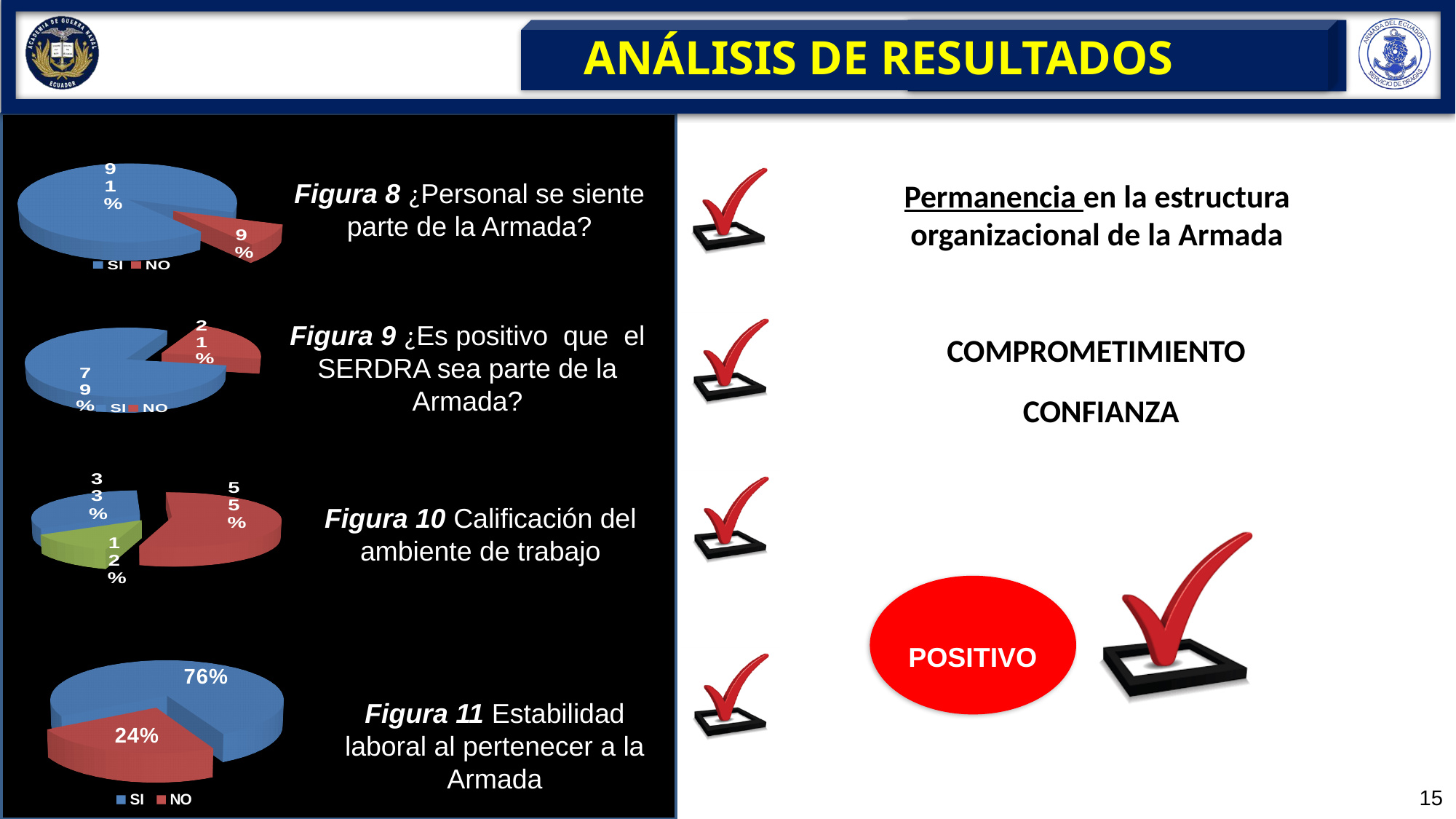
In the Figura 9 pie chart, what percentage is shown for SI? 79% In the Figura 8 pie chart, what percentage is shown for NO? 9% In the Figura 10 pie chart (Calificación del ambiente de trabajo), what percentage is shown on the red slice? 55% In the Figura 8 pie chart (¿Personal se siente parte de la Armada?), what percentage is shown for SI? 91% In the Figura 9 pie chart (¿Es positivo que el SERDRA sea parte de la Armada?), what percentage is shown for NO? 21% What type of chart is Figura 8? Pie chart In the Figura 9 pie chart, which is larger, SI or NO? SI How many entries does the legend of the Figura 11 pie chart list? 2 In the Figura 10 pie chart, which slice is the smallest? The green slice (12%) In the Figura 11 pie chart (Estabilidad laboral al pertenecer a la Armada), what percentage is shown for SI? 76% In the Figura 11 pie chart, what is the difference in percentage points between SI and NO? 52 How many slices does the Figura 10 pie chart have? 3